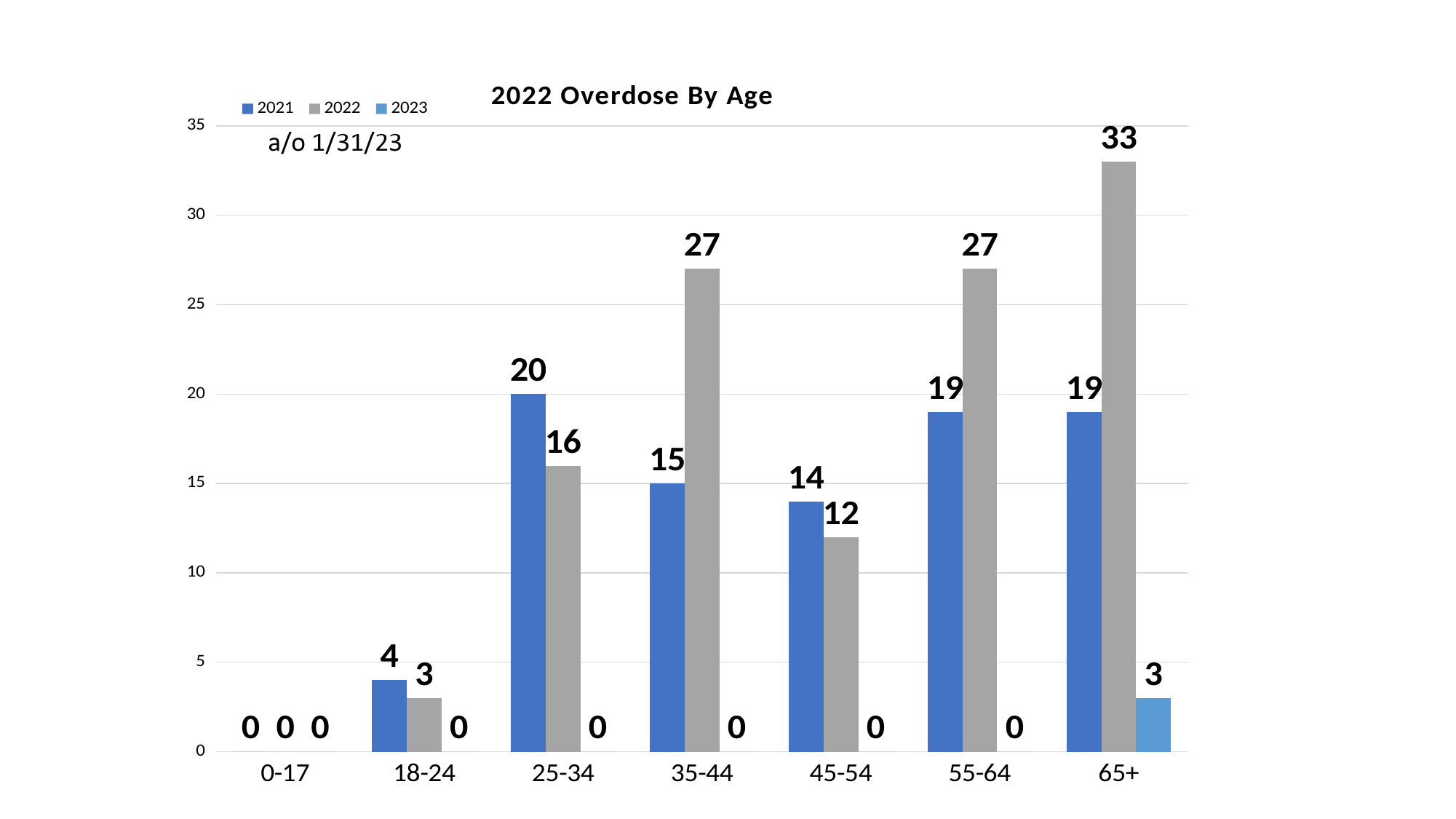
What is the 2021 value for the 25-34 age group? 20 Which is larger for the 25-34 age group, the 2021 value or the 2022 value? 2021 What kind of chart is shown on the slide? Bar chart How many series does the legend list? 3 What is the difference between the 2022 and 2021 values for the 65+ age group? 14 What is the 2023 value for the 65+ age group? 3 What is the title of the chart? 2022 Overdose By Age How many age groups are shown on the x axis? 7 Which age group has the lowest 2021 value? 0-17 What is the 2022 value for the 45-54 age group? 12 What is the 2022 value for the 65+ age group? 33 Which age group has the highest 2022 value? 65+